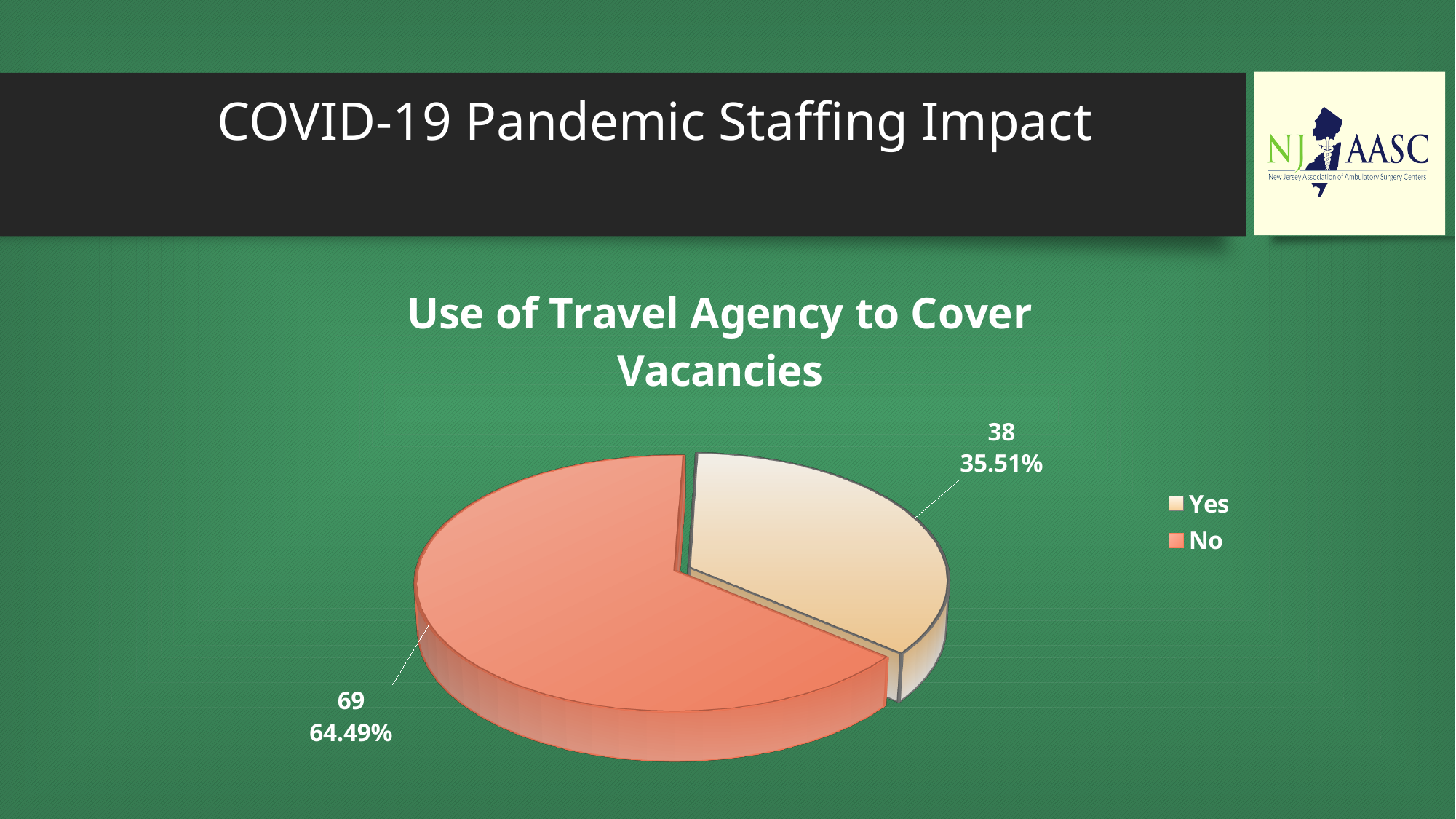
Which category has the smallest slice? Yes Which is larger, the "Yes" slice or the "No" slice? No What is the difference between the number of "No" and "Yes" responses? 31 Which category has the largest slice? No What percentage of the pie does the "Yes" slice represent? 35.51% What is the total number of responses shown in the pie chart? 107 What percentage of the pie does the "No" slice represent? 64.49% What is the title of the chart? Use of Travel Agency to Cover Vacancies How many categories does the legend list? 2 What kind of chart is shown on the slide? pie chart How many respondents answered "No"? 69 How many respondents answered "Yes"? 38